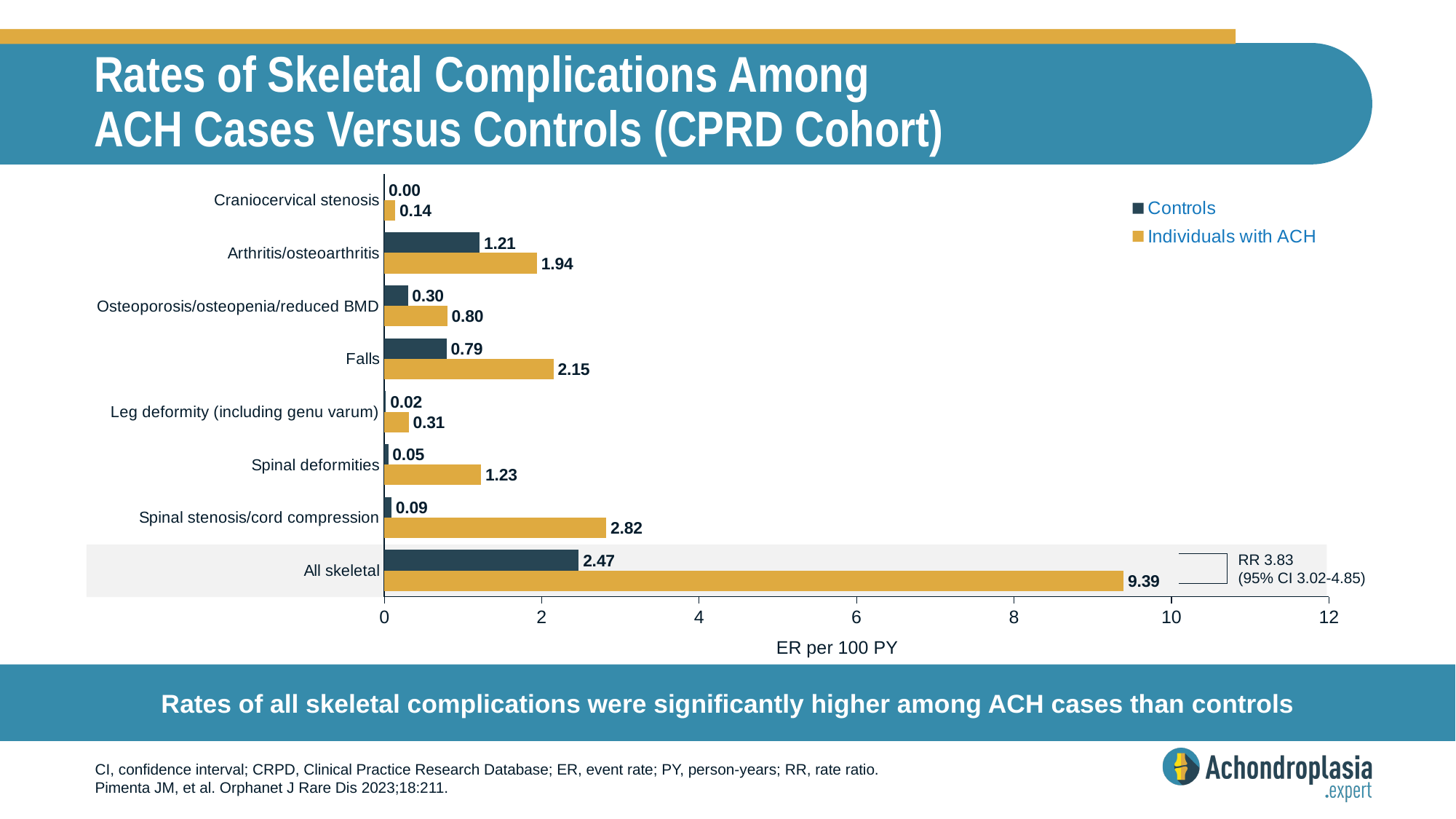
Which category has the highest value for Individuals with ACH? All skeletal How many series does the legend list? 2 What kind of chart is shown on the slide? Bar chart Which is larger for Osteoporosis/osteopenia/reduced BMD: the Controls value or the Individuals with ACH value? Individuals with ACH What is the ER per 100 PY for Spinal stenosis/cord compression among Individuals with ACH? 2.82 What is the ER per 100 PY for Falls among Individuals with ACH? 2.15 What is the label of the x axis? ER per 100 PY Which category has the lowest value for Controls? Craniocervical stenosis How many categories are shown on the y axis of the chart? 8 What is the ER per 100 PY for Arthritis/osteoarthritis among Controls? 1.21 Is the value for All skeletal among Individuals with ACH greater or less than 8? greater What is the difference between the Individuals with ACH and Controls values for All skeletal? 6.92